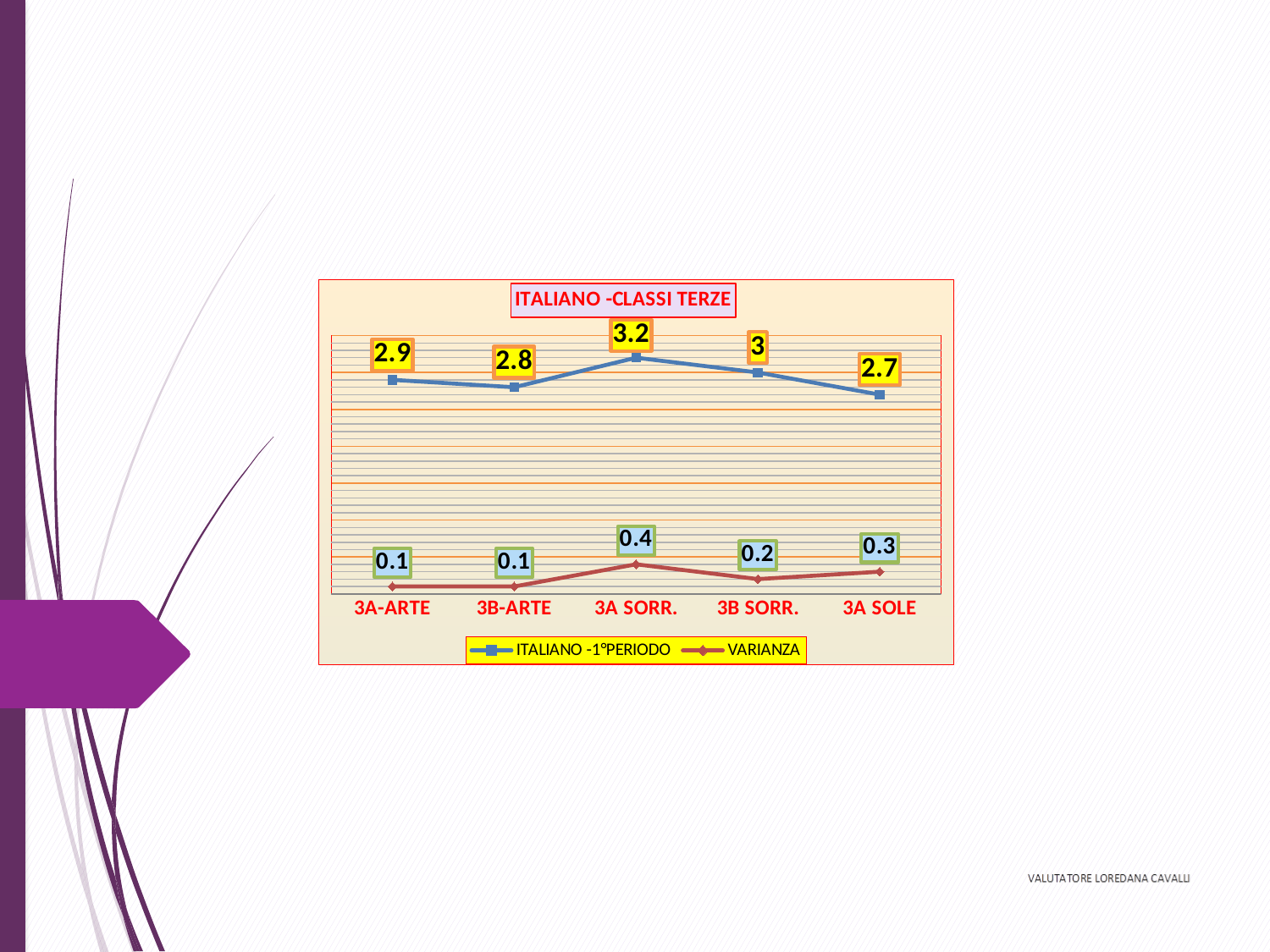
Which is larger, the ITALIANO -1°PERIODO value for 3A-ARTE or for 3B SORR.? 3B SORR. What is the ITALIANO -1°PERIODO value for 3A SOLE? 2.7 What is the ITALIANO -1°PERIODO value for 3A SORR.? 3.2 What kind of chart is shown? Line chart What is the VARIANZA value for 3B SORR.? 0.2 How many series does the legend list? 2 What is the title of the chart? ITALIANO -CLASSI TERZE Which class has the highest ITALIANO -1°PERIODO value? 3A SORR. How many classes are shown on the x axis? 5 What is the difference between the ITALIANO -1°PERIODO values for 3A SORR. and 3A SOLE? 0.5 Which class has the highest VARIANZA value? 3A SORR. Which class has the lowest ITALIANO -1°PERIODO value? 3A SOLE